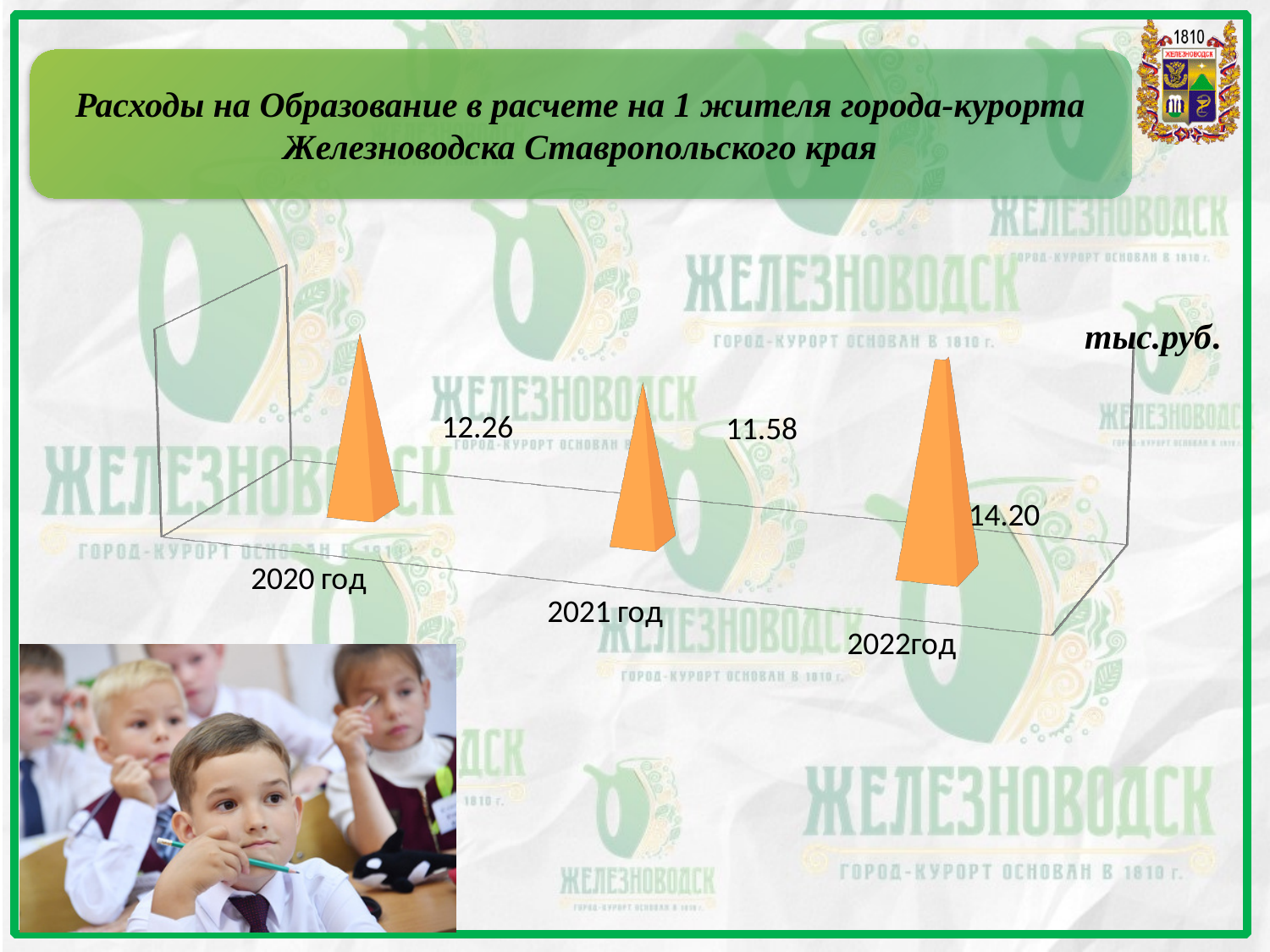
What is the title of the chart? Расходы на Образование в расчете на 1 жителя города-курорта Железноводска Ставропольского края Which is larger, the value for 2020 год or the value for 2022год? 2022год What unit is indicated for the values on the chart? тыс.руб. Which year has the lowest value? 2021 год What kind of chart is shown on the slide? bar chart What is the difference between the values for 2022год and 2021 год? 2.62 What is the value for 2020 год? 12.26 What is the value for 2022год? 14.20 What is the value for 2021 год? 11.58 Which year has the highest value? 2022год What is the difference between the values for 2020 год and 2021 год? 0.68 How many years are shown on the chart? 3